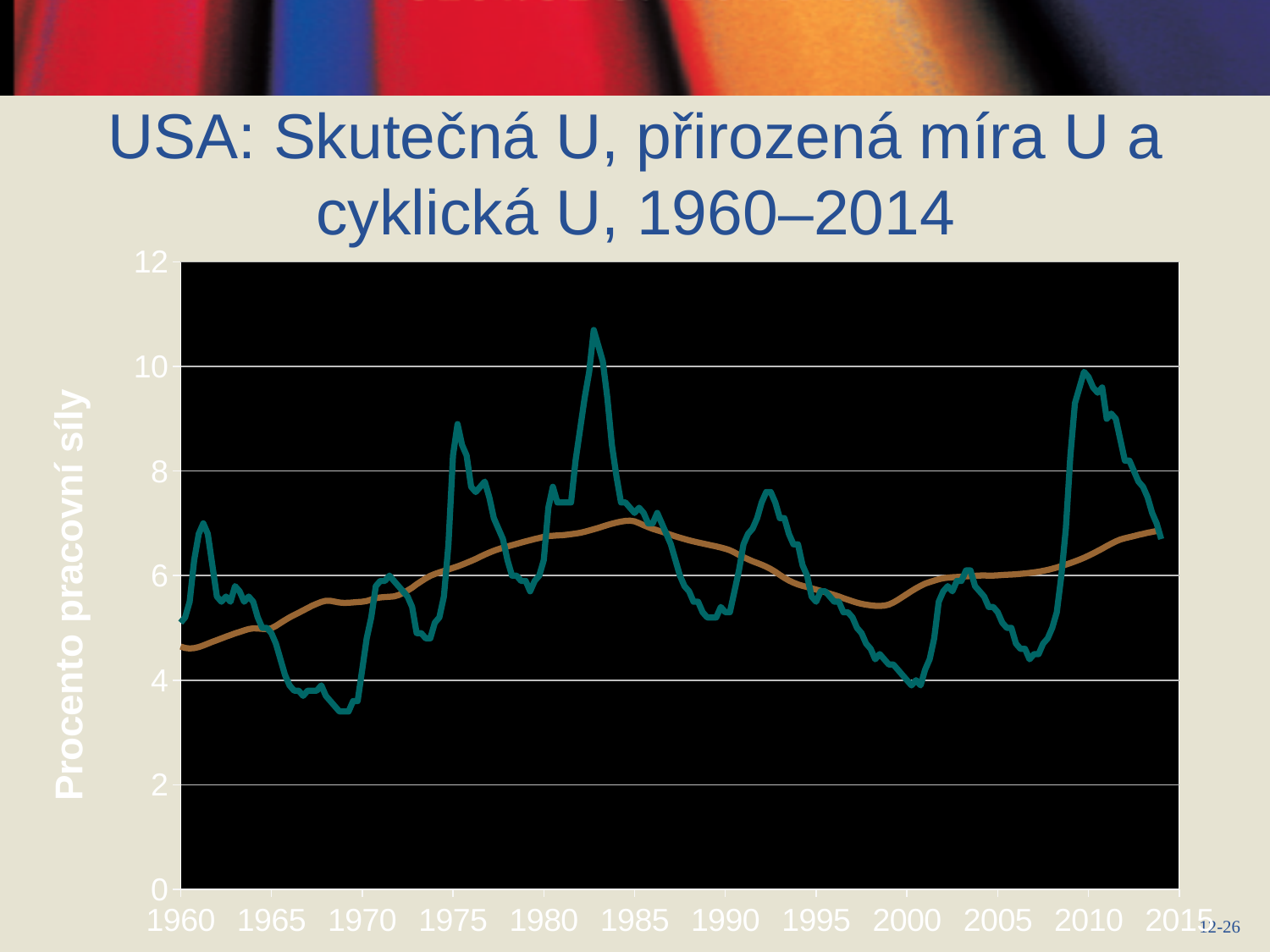
What is the title of the chart? USA: Skutečná U, přirozená míra U a cyklická U, 1960–2014 What is the label on the vertical axis of the chart? Procento pracovní síly What is the highest value shown on the vertical axis? 12 What kind of chart is shown on the slide? line chart Is the value of the brown line in 1960 greater or less than 6? less How many lines are plotted on the chart? 2 Is the value of the teal line around 1969 greater or less than 4? less Does the brown line rise or fall between 1960 and 1985? rise Is the peak of the teal line around 2010 greater or less than 8? greater